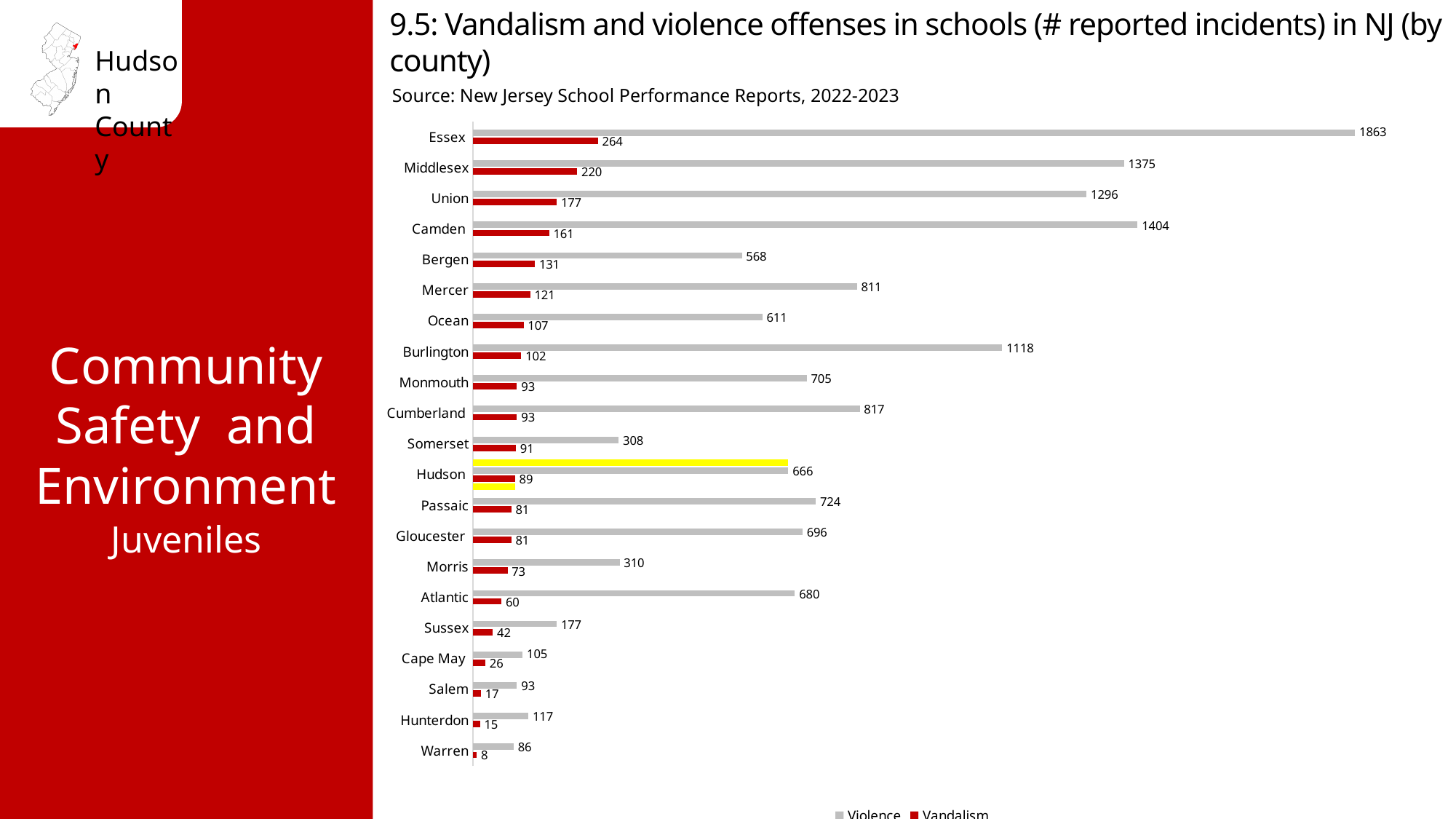
What is the difference between the violence incidents in Essex and Middlesex? 488 Which county has the highest number of reported violence incidents? Essex What is the difference between the violence and vandalism incidents in Burlington? 1016 How many series does the legend list? 2 What is the number of reported vandalism incidents in Hudson County? 89 What is the number of reported violence incidents in Hudson County? 666 How many counties are shown in the chart? 21 Which county has the lowest number of reported vandalism incidents? Warren What is the number of reported vandalism incidents in Cape May? 26 Which series is shown in red in the chart? Vandalism Which county has more reported violence incidents, Camden or Union? Camden What kind of chart is shown on the slide? Bar chart